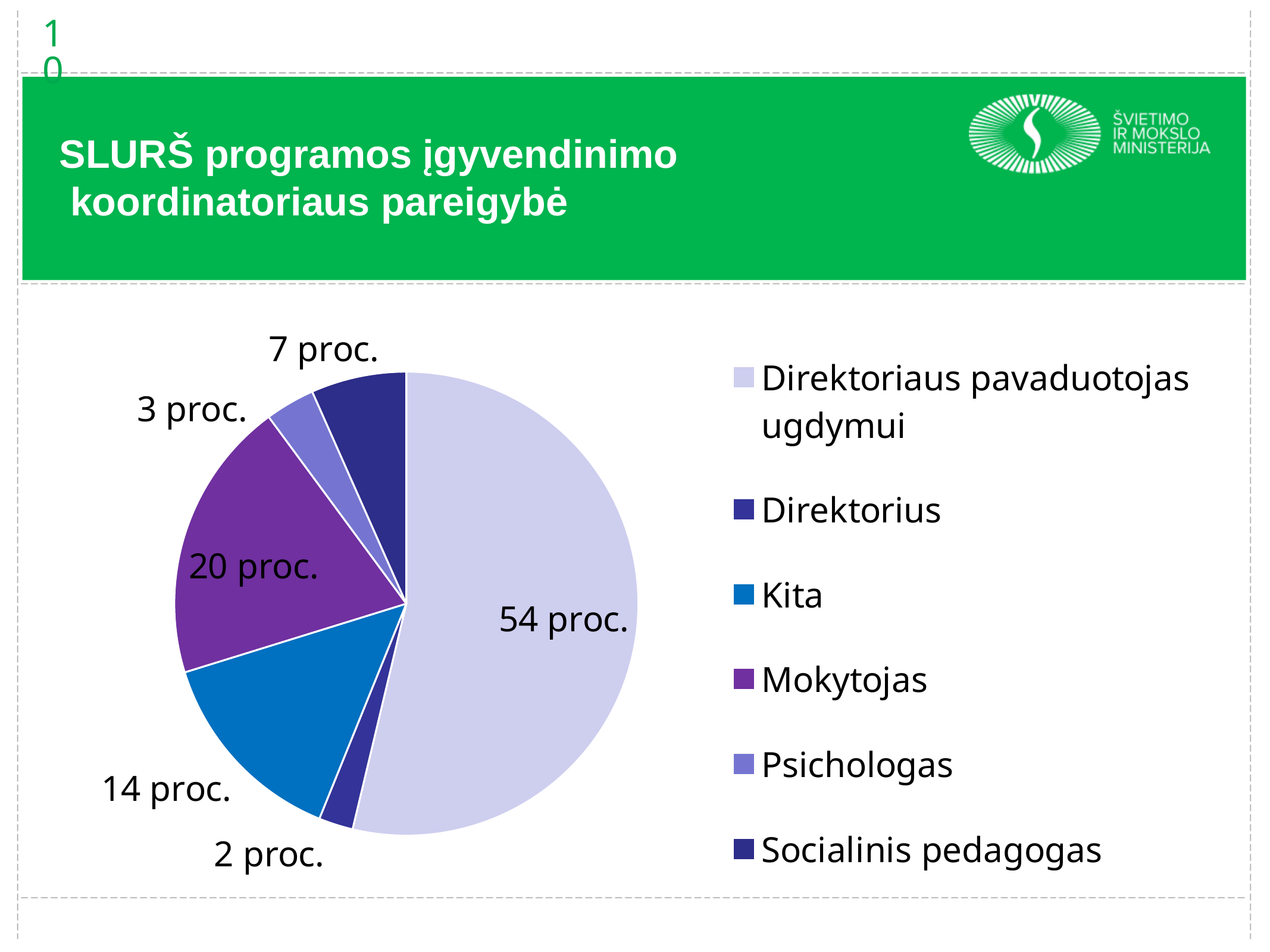
What share of the pie is labelled for Mokytojas? 20 proc. What share of the pie is labelled for Kita? 14 proc. Which category has the largest slice of the pie? Direktoriaus pavaduotojas ugdymui How many categories does the pie chart have? 6 What is the title of the slide containing the pie chart? SLURŠ programos įgyvendinimo koordinatoriaus pareigybė What kind of chart is shown on the slide? pie chart Which is larger, the share for Socialinis pedagogas or the share for Psichologas? Socialinis pedagogas What share of the pie is labelled for Direktoriaus pavaduotojas ugdymui? 54 proc. Which category has the smallest slice of the pie? Direktorius What is the difference between the Mokytojas share and the Kita share? 6 proc. What share of the pie is labelled for Psichologas? 3 proc. What share of the pie is labelled for Socialinis pedagogas? 7 proc.